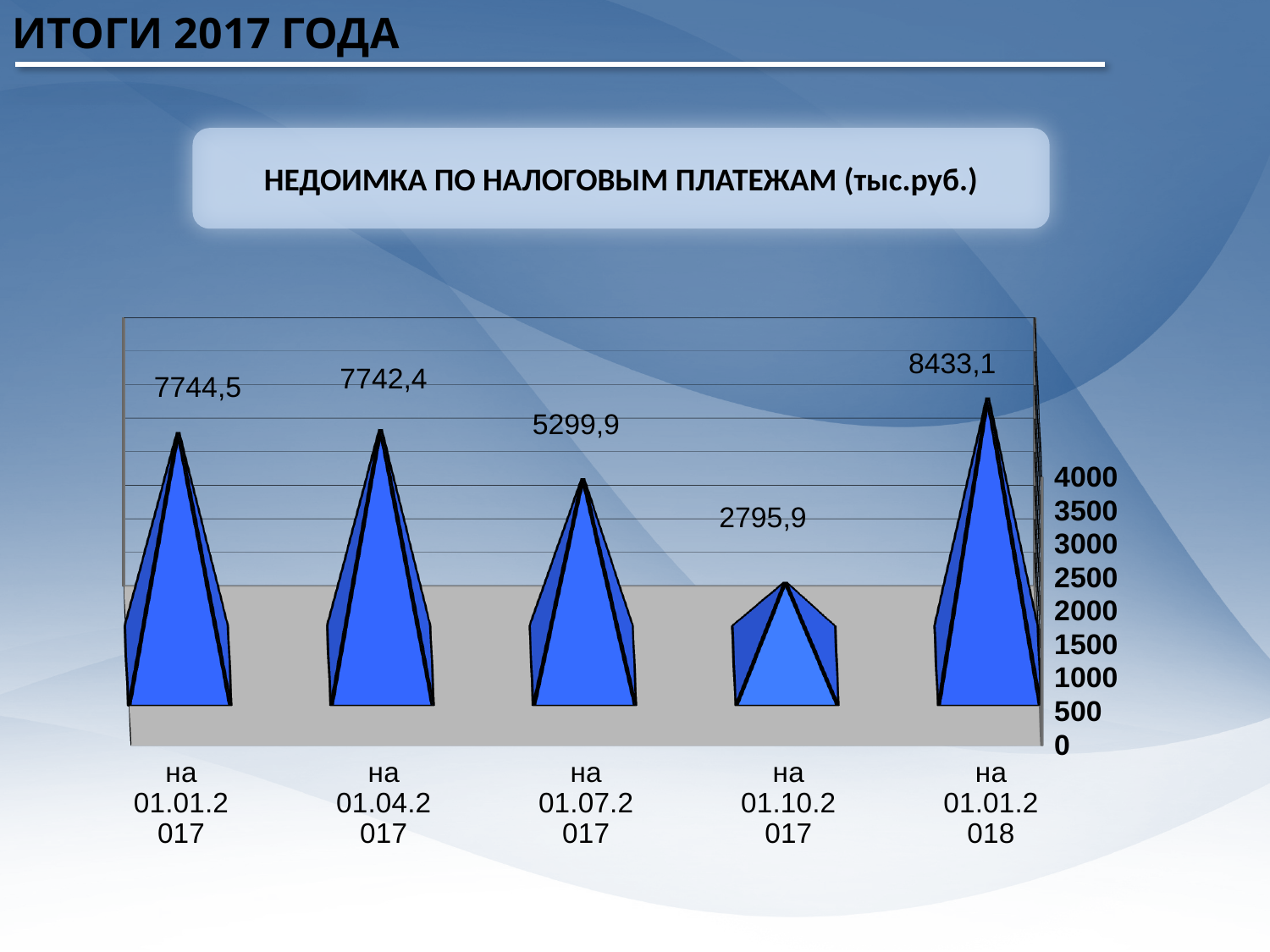
How many dates are shown on the chart? 5 What is the value for на 01.10.2017? 2795,9 What is the value for на 01.01.2017? 7744,5 What is the difference between the values for на 01.01.2018 and на 01.01.2017? 688,6 What kind of chart is shown? bar chart What is the value for на 01.07.2017? 5299,9 Which is larger, the value for на 01.07.2017 or на 01.10.2017? на 01.07.2017 What is the value for на 01.01.2018? 8433,1 Which date has the lowest value? на 01.10.2017 Which date has the highest value? на 01.01.2018 What is the title of the chart? НЕДОИМКА ПО НАЛОГОВЫМ ПЛАТЕЖАМ (тыс.руб.) What is the difference between the values for на 01.07.2017 and на 01.10.2017? 2504